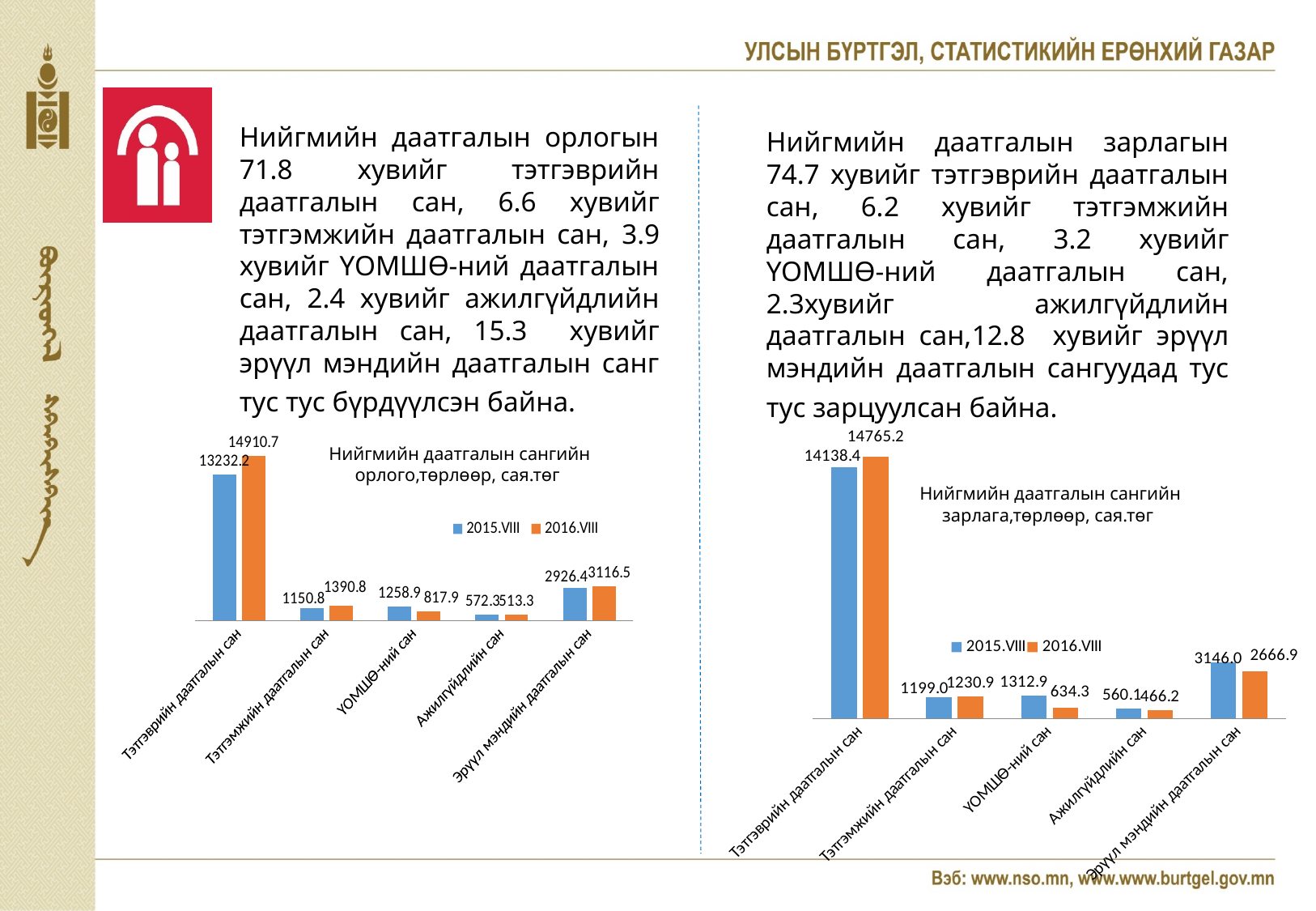
In the left chart (Нийгмийн даатгалын сангийн орлого), which is larger for ҮОМШӨ-ний сан: the 2015.VIII value or the 2016.VIII value? 2015.VIII What type of chart is the right chart (Нийгмийн даатгалын сангийн зарлага)? Bar chart In the right chart (Нийгмийн даатгалын сангийн зарлага), what is the 2016.VIII value for Эрүүл мэндийн даатгалын сан? 2666.9 In the left chart (Нийгмийн даатгалын сангийн орлого), which category has the lowest 2016.VIII value? Ажилгүйдлийн сан How many categories are shown on the x axis of the right chart (Нийгмийн даатгалын сангийн зарлага)? 5 How many series does the legend of the left chart (Нийгмийн даатгалын сангийн орлого) list? 2 In the left chart (Нийгмийн даатгалын сангийн орлого), what is the 2016.VIII value for Тэтгэврийн даатгалын сан? 14910.7 In the right chart (Нийгмийн даатгалын сангийн зарлага), which category has the highest 2015.VIII value? Тэтгэврийн даатгалын сан In the left chart (Нийгмийн даатгалын сангийн орлого), what is the 2015.VIII value for ҮОМШӨ-ний сан? 1258.9 In the right chart (Нийгмийн даатгалын сангийн зарлага), what is the 2015.VIII value for Тэтгэврийн даатгалын сан? 14138.4 In the right chart (Нийгмийн даатгалын сангийн зарлага), what is the difference between the 2015.VIII and 2016.VIII values for ҮОМШӨ-ний сан? 678.6 In the left chart (Нийгмийн даатгалын сангийн орлого), what is the difference between the 2016.VIII and 2015.VIII values for Тэтгэврийн даатгалын сан? 1678.5